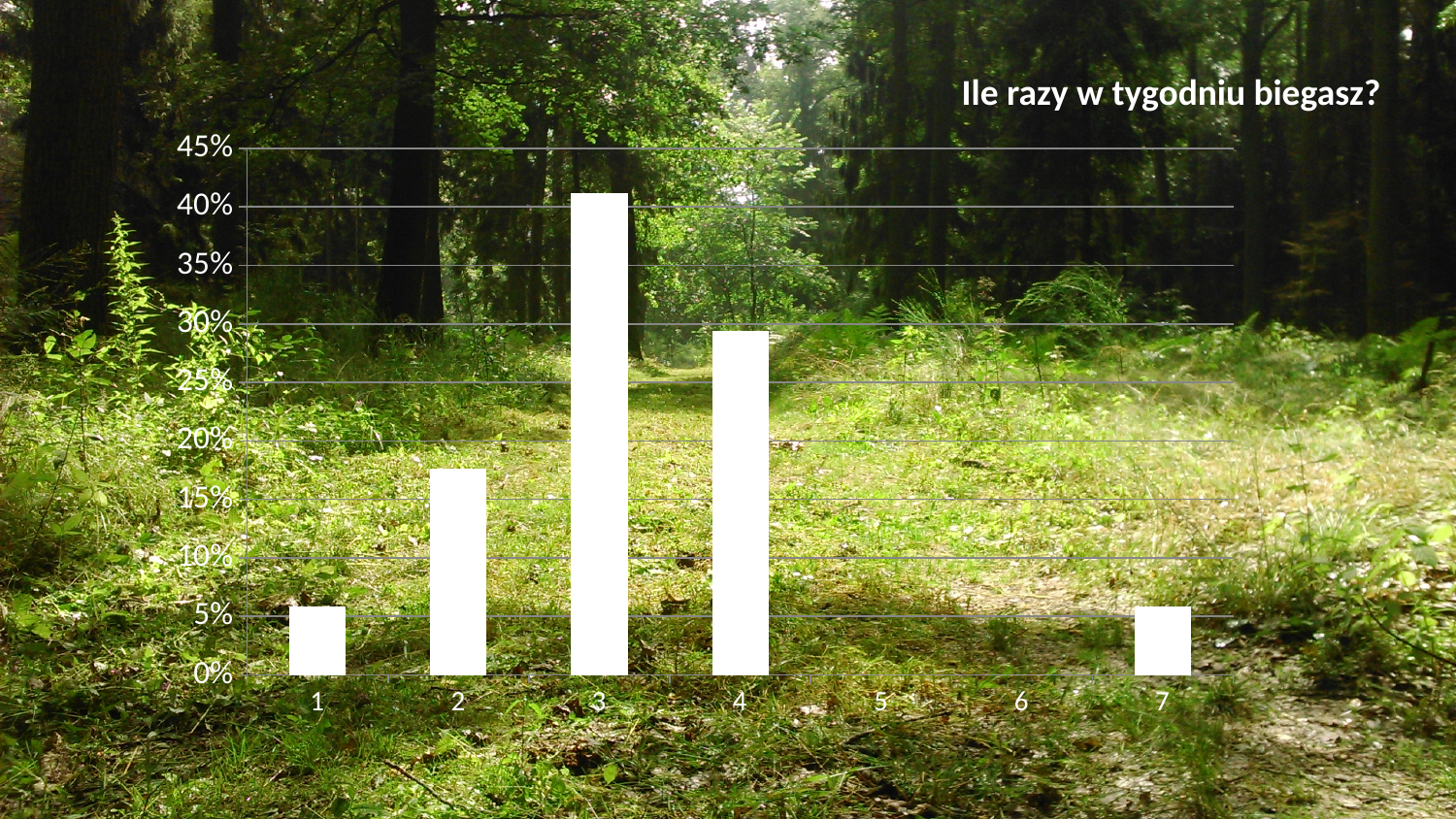
Which category has the highest bar in the chart? 3 How many categories are shown on the x axis of the chart? 7 Is the value for category 3 greater or less than 35%? greater What is the title of the chart? Ile razy w tygodniu biegasz? Is the value for category 2 greater or less than 15%? greater Is the value for category 2 greater or less than 20%? less Which is larger, the value for category 2 or the value for category 4? 4 What type of chart is shown on the slide? bar chart Do the values rise or fall from category 3 to category 4? fall